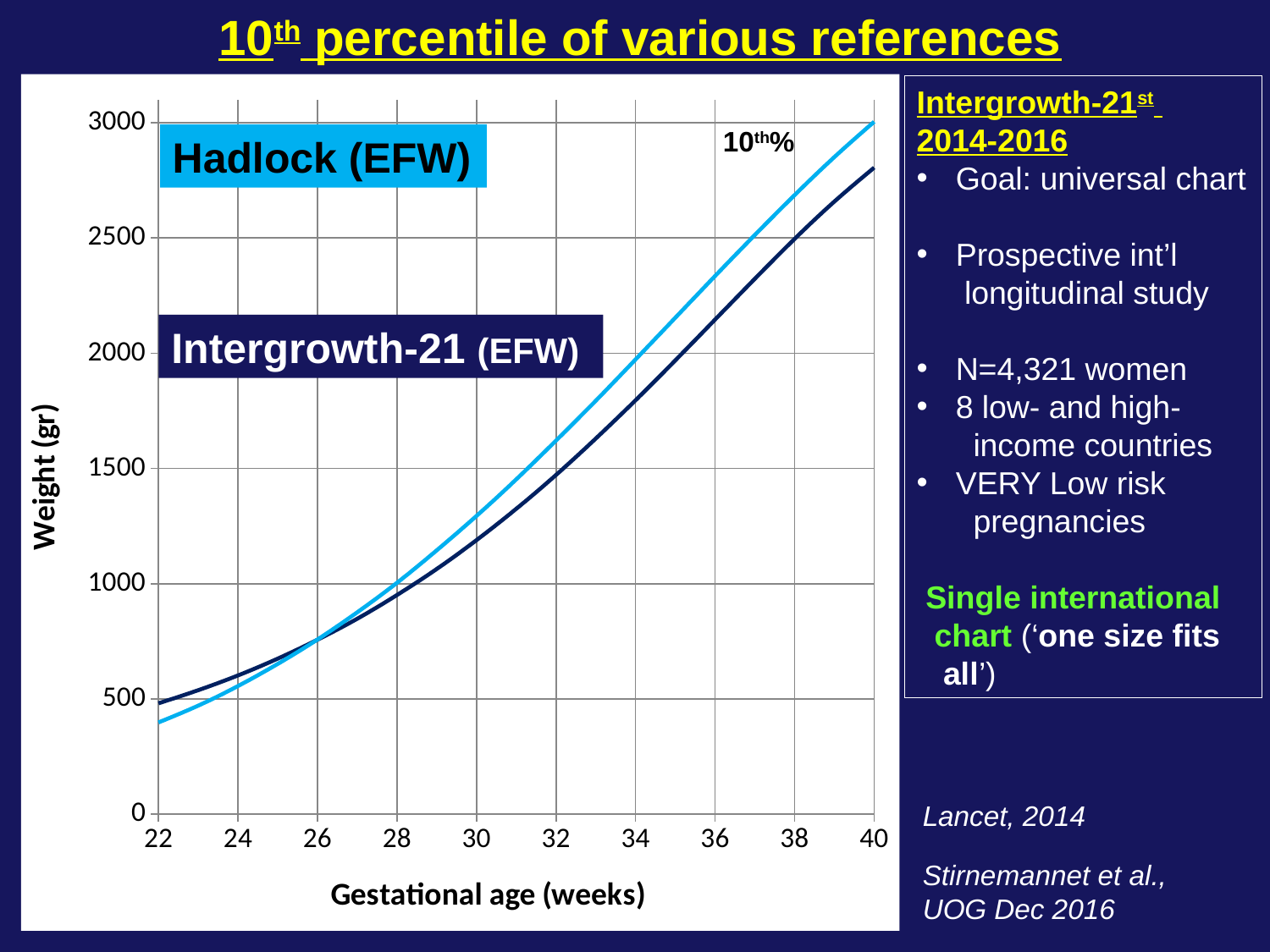
Is the Hadlock (EFW) value at 22 weeks greater or less than 500? less At 36 weeks, which series has the higher weight, Hadlock (EFW) or Intergrowth-21 (EFW)? Hadlock (EFW) At 24 weeks, which series has the higher weight, Hadlock (EFW) or Intergrowth-21 (EFW)? Intergrowth-21 (EFW) What is the label of the y axis? Weight (gr) Is the Intergrowth-21 (EFW) value at 34 weeks greater or less than 2000? less Do the weight values rise or fall as gestational age increases? rise Is the Intergrowth-21 (EFW) value at 40 weeks greater or less than 3000? less What is the title of the chart? 10th percentile of various references How many series are plotted on the chart? 2 What kind of chart is shown on the slide? line chart